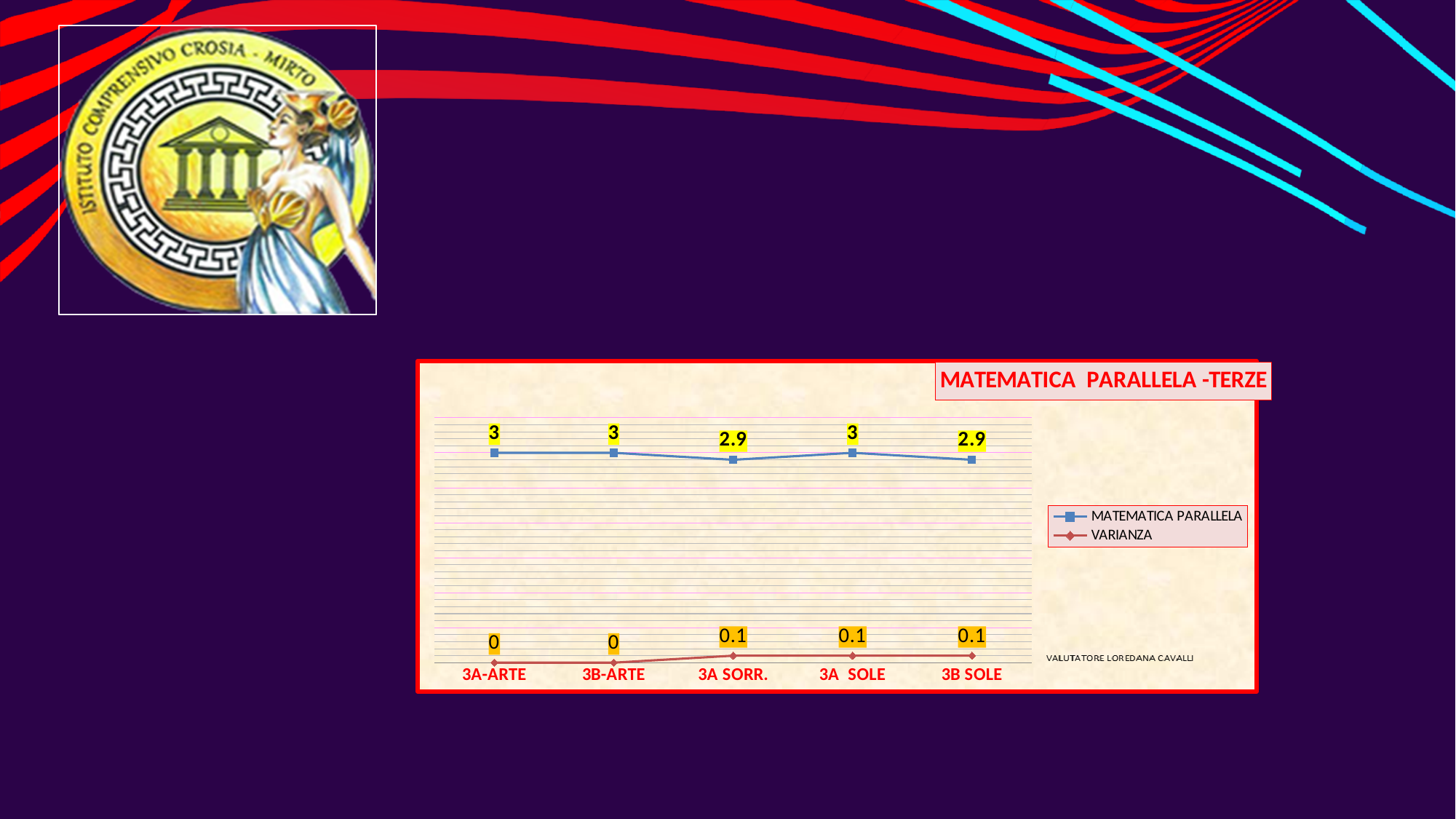
What is the MATEMATICA PARALLELA value for 3A SORR.? 2.9 What is the difference between the MATEMATICA PARALLELA values for 3A SOLE and 3B SOLE? 0.1 What kind of chart is shown? line chart How many series does the legend list? 2 What is the title of the chart? MATEMATICA PARALLELA -TERZE What is the MATEMATICA PARALLELA value for 3B-ARTE? 3 Which series is drawn in blue? MATEMATICA PARALLELA Which is larger, the MATEMATICA PARALLELA value for 3A-ARTE or for 3A SORR.? 3A-ARTE What is the VARIANZA value for 3A-ARTE? 0 Which category has the lowest VARIANZA value among 3A SORR., 3A SOLE and 3B-ARTE? 3B-ARTE What is the VARIANZA value for 3B SOLE? 0.1 How many categories are shown on the x axis? 5